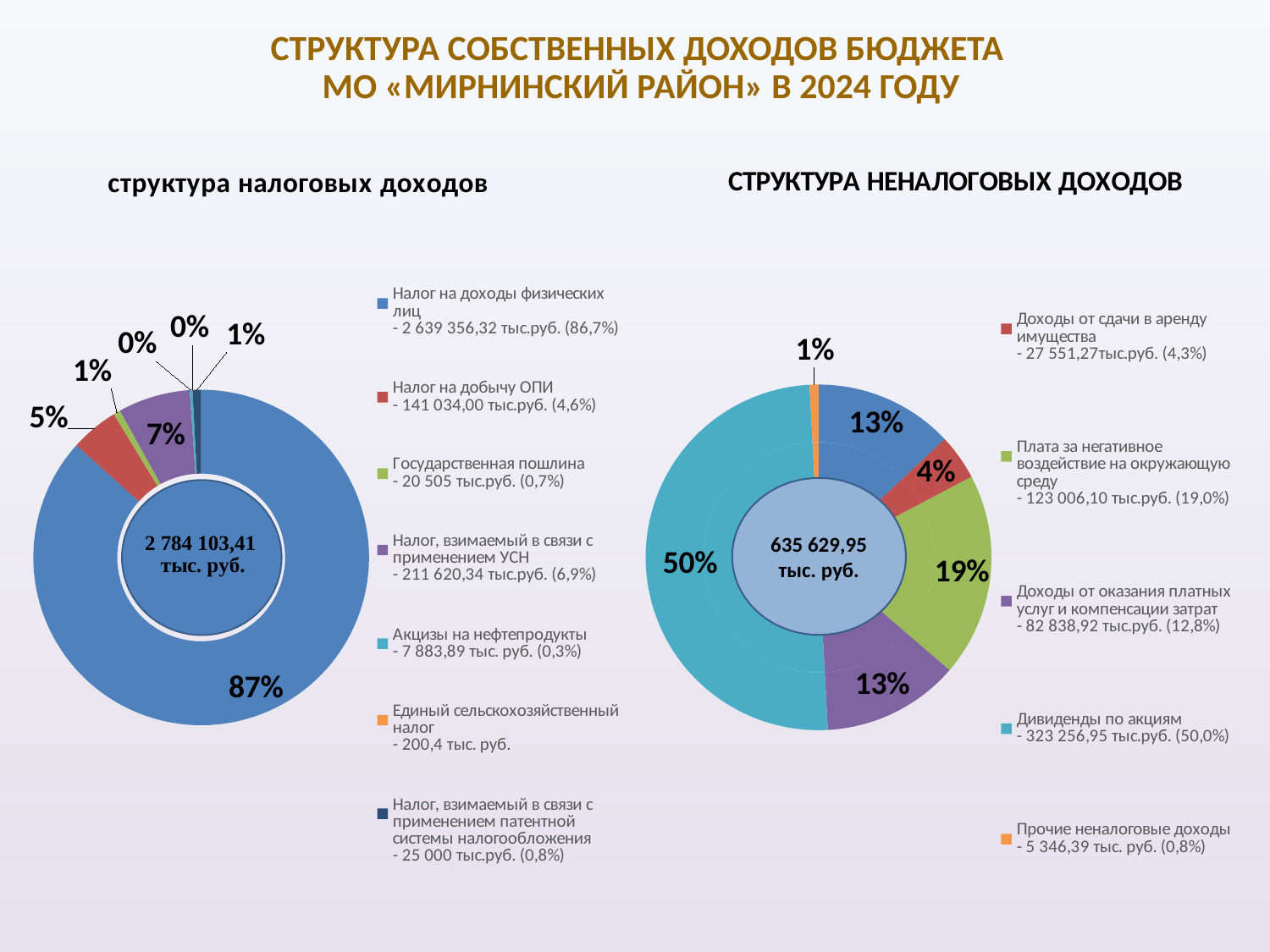
In the left chart 'структура налоговых доходов', what value is given for 'Налог на добычу ОПИ'? 141 034,00 тыс.руб. How many entries does the legend of the left chart 'структура налоговых доходов' list? 7 In the right chart 'СТРУКТУРА НЕНАЛОГОВЫХ ДОХОДОВ', what share does 'Плата за негативное воздействие на окружающую среду' have according to the legend? 19,0% What total is printed in the centre of the left chart 'структура налоговых доходов'? 2 784 103,41 тыс. руб. In the left chart 'структура налоговых доходов', which is larger: 'Налог, взимаемый в связи с применением УСН' or 'Налог на добычу ОПИ'? Налог, взимаемый в связи с применением УСН In the left chart 'структура налоговых доходов', which category has the largest share? Налог на доходы физических лиц What kind of chart is used for the 'структура налоговых доходов' on the left of the slide? pie chart (doughnut) In the right chart 'СТРУКТУРА НЕНАЛОГОВЫХ ДОХОДОВ', what value is given for 'Дивиденды по акциям'? 323 256,95 тыс.руб. In the right chart 'СТРУКТУРА НЕНАЛОГОВЫХ ДОХОДОВ', what is the difference between 'Дивиденды по акциям' and 'Плата за негативное воздействие на окружающую среду'? 200 250,85 тыс.руб. What total is printed in the centre of the right chart 'СТРУКТУРА НЕНАЛОГОВЫХ ДОХОДОВ'? 635 629,95 тыс. руб. In the left chart 'структура налоговых доходов', what percentage label is shown on the largest slice? 87% In the right chart 'СТРУКТУРА НЕНАЛОГОВЫХ ДОХОДОВ', which legend category has the smallest value? Прочие неналоговые доходы